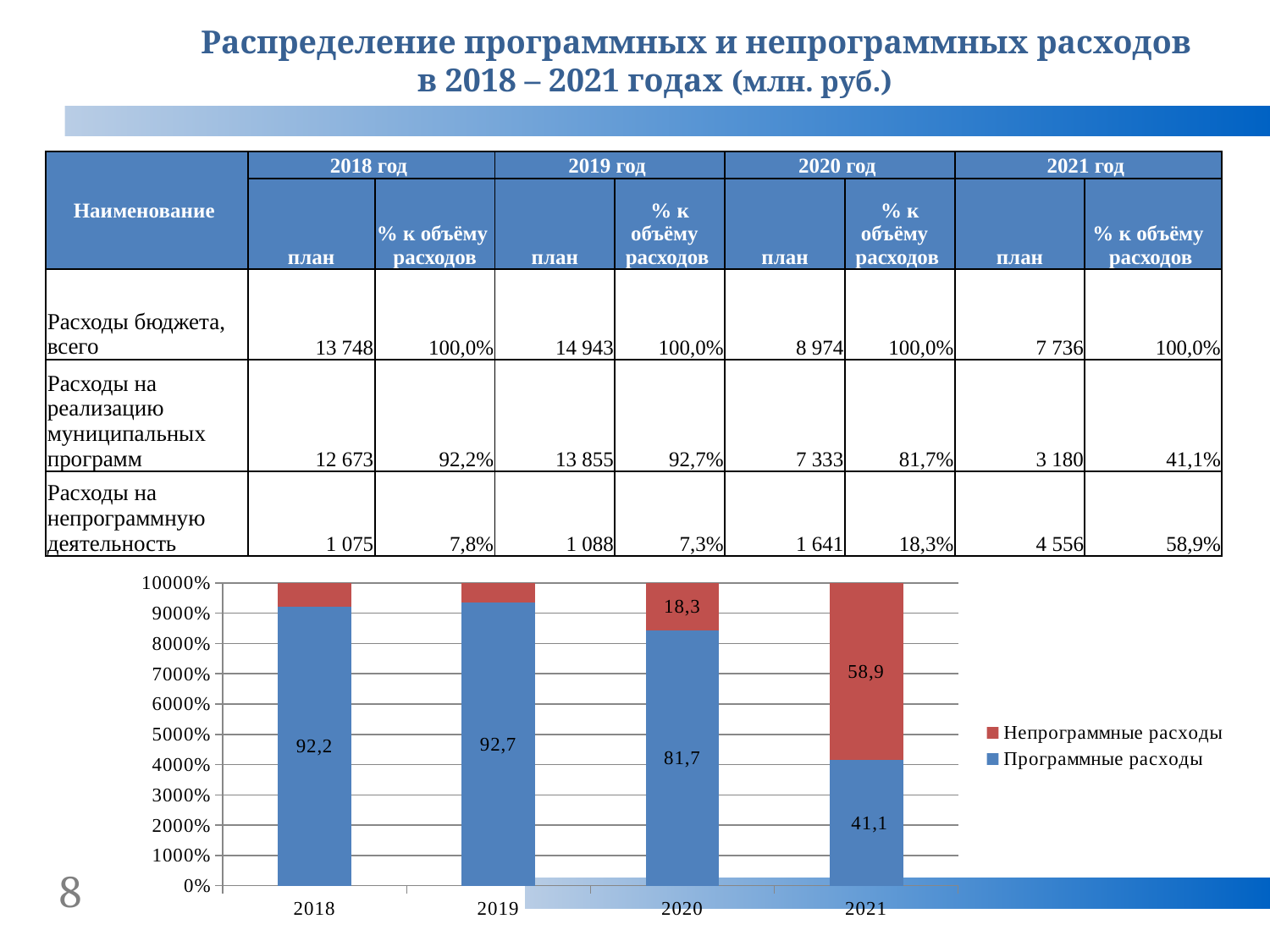
What is the labelled value for Программные расходы in 2021 on the chart? 41,1 On the chart, by how much does the 2021 value for Непрограммные расходы exceed the 2021 value for Программные расходы? 17,8 In which year is the labelled value for Программные расходы the lowest on the chart? 2021 How many years are shown on the x axis of the chart? 4 What kind of chart is shown at the bottom of the slide? Stacked bar chart What is the labelled value for Программные расходы in 2018 on the chart? 92,2 Does the labelled value for Программные расходы rise or fall from 2019 to 2021 on the chart? Fall How many series does the chart legend list? 2 What is the labelled value for Непрограммные расходы in 2020 on the chart? 18,3 In which year is the labelled value for Программные расходы the highest on the chart? 2019 In 2020, which series has the larger labelled value on the chart: Программные расходы or Непрограммные расходы? Программные расходы What is the labelled value for Непрограммные расходы in 2021 on the chart? 58,9